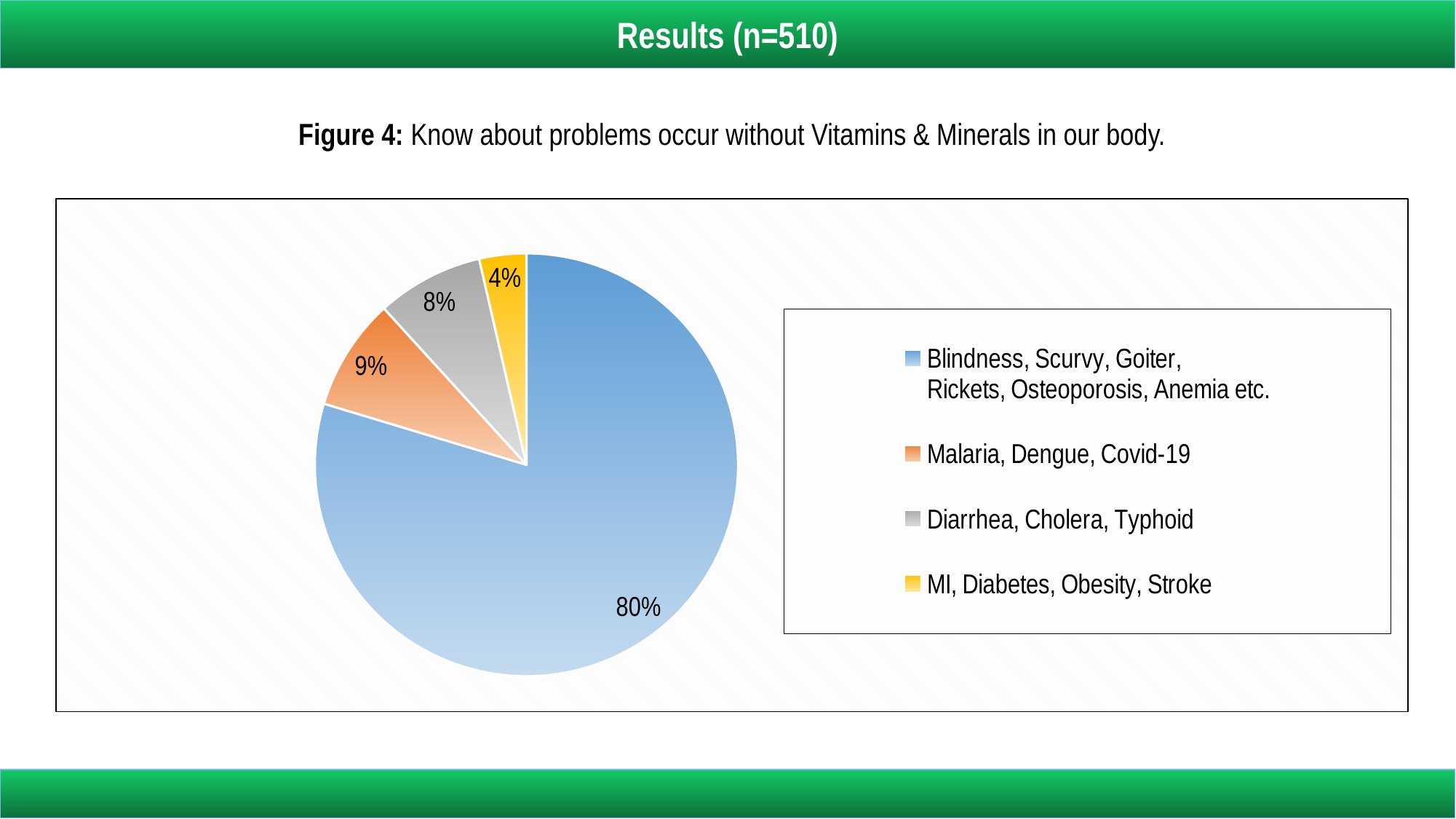
Which category has the largest slice of the pie? Blindness, Scurvy, Goiter, Rickets, Osteoporosis, Anemia etc. What percentage of the pie is labelled for MI, Diabetes, Obesity, Stroke? 4% What kind of chart is shown on the slide? Pie chart What colour is the slice for Malaria, Dengue, Covid-19? Orange Which category has the smallest slice of the pie? MI, Diabetes, Obesity, Stroke Which slice is larger: Diarrhea, Cholera, Typhoid or MI, Diabetes, Obesity, Stroke? Diarrhea, Cholera, Typhoid What is the difference in percentage points between the Blindness, Scurvy, Goiter, Rickets, Osteoporosis, Anemia etc. slice and the Malaria, Dengue, Covid-19 slice? 71 What percentage of the pie is labelled for Blindness, Scurvy, Goiter, Rickets, Osteoporosis, Anemia etc.? 80% What is the figure caption above the chart? Figure 4: Know about problems occur without Vitamins & Minerals in our body. What percentage of the pie is labelled for Diarrhea, Cholera, Typhoid? 8% What percentage of the pie is labelled for Malaria, Dengue, Covid-19? 9% How many categories does the pie chart show? 4